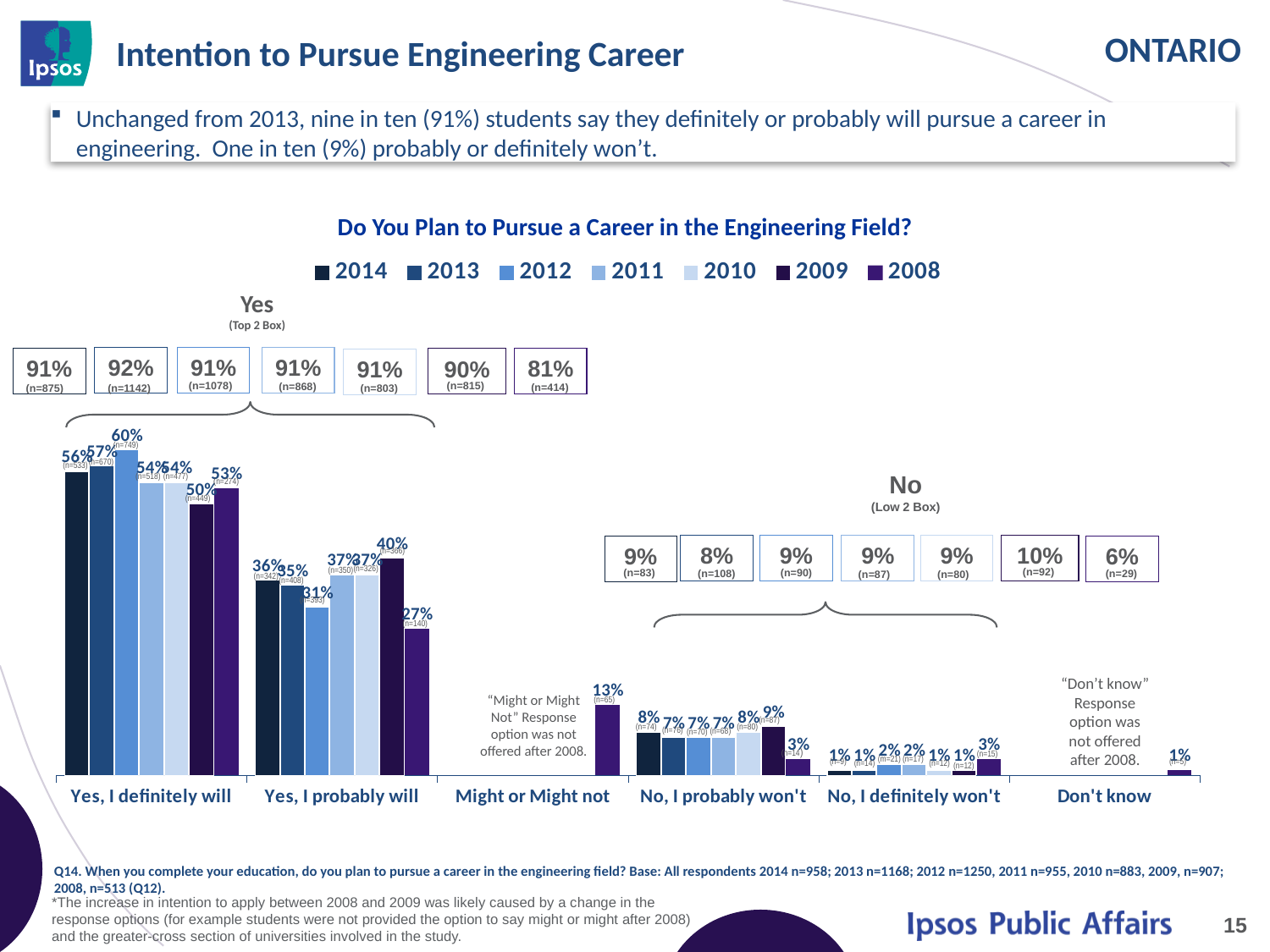
How many response categories are shown on the x axis? 6 What is the 2008 value for "Might or Might not"? 13% What is the title of the chart? Do You Plan to Pursue a Career in the Engineering Field? What is the 2009 value for "No, I probably won't"? 9% Which year has the highest value for "Yes, I definitely will"? 2012 How many years does the legend list? 7 What is the 2008 value for "No, I definitely won't"? 3% For "Yes, I probably will", which is larger: the 2009 value or the 2008 value? 2009 What is the 2012 value for "Yes, I definitely will"? 60% What is the difference between the 2014 values for "Yes, I definitely will" and "Yes, I probably will"? 20 percentage points What kind of chart is shown on the slide? Bar chart Which year has the lowest value for "Yes, I probably will"? 2008